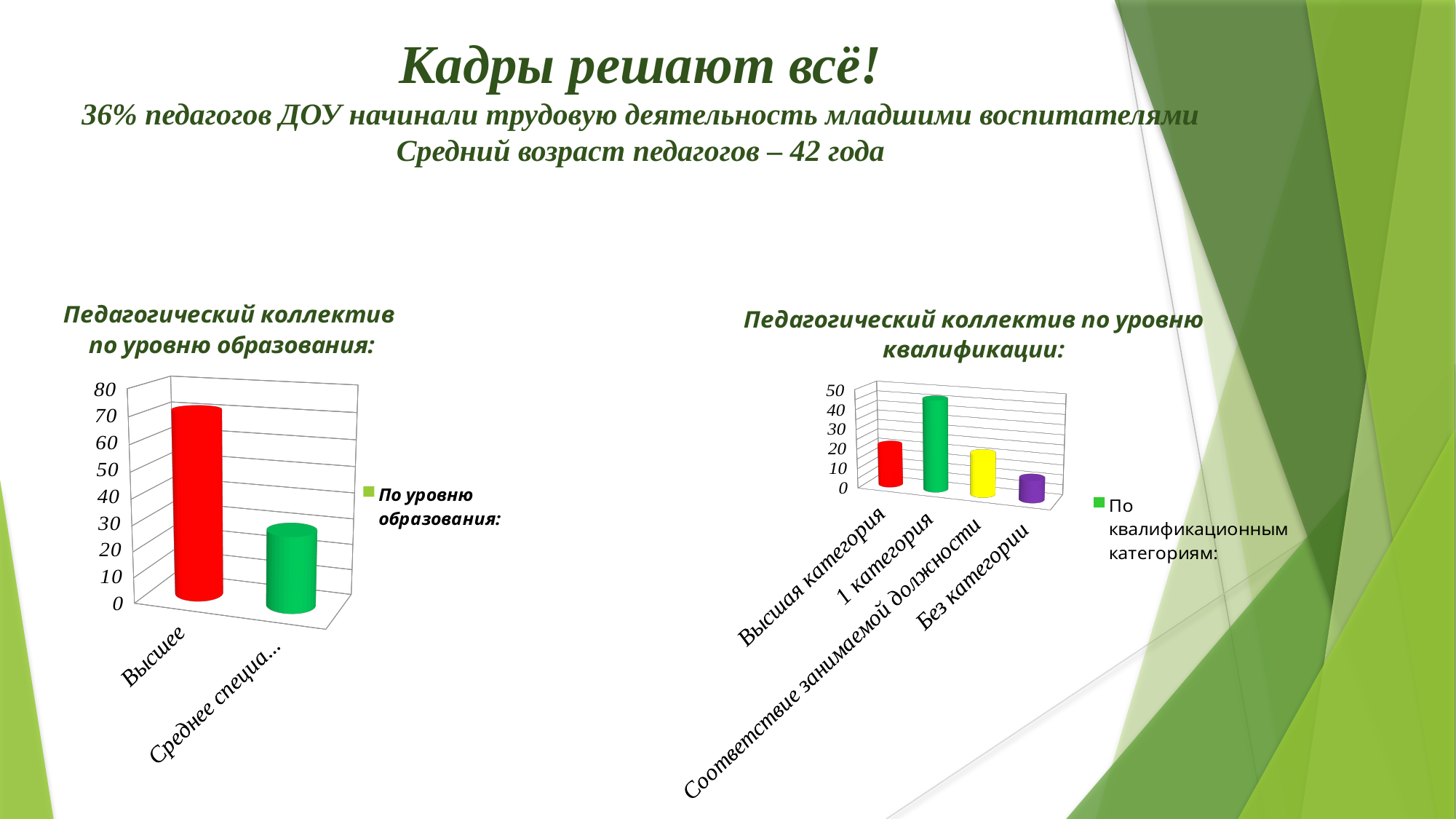
How many categories are shown in the 'Педагогический коллектив по уровню образования' chart on the left? 2 In the right chart 'Педагогический коллектив по уровню квалификации', which is larger: Высшая категория or Без категории? Высшая категория How many categories are shown in the right chart 'Педагогический коллектив по уровню квалификации'? 4 In the left chart 'Педагогический коллектив по уровню образования', which category has the highest value? Высшее What is the legend entry of the right chart 'Педагогический коллектив по уровню квалификации'? По квалификационным категориям: In the right chart 'Педагогический коллектив по уровню квалификации', which category has the lowest value? Без категории In the right chart 'Педагогический коллектив по уровню квалификации', which category has the highest value? 1 категория In the right chart 'Педагогический коллектив по уровню квалификации', is the value for 1 категория greater or less than 40? greater What kind of chart is the 'Педагогический коллектив по уровню образования' chart on the left? bar chart In the left chart 'Педагогический коллектив по уровню образования', is the value for the second bar (Среднее специа...) greater or less than 40? less In the left chart 'Педагогический коллектив по уровню образования', is the value for Высшее greater or less than 60? greater How many series does the legend of the left chart 'Педагогический коллектив по уровню образования' list? 1